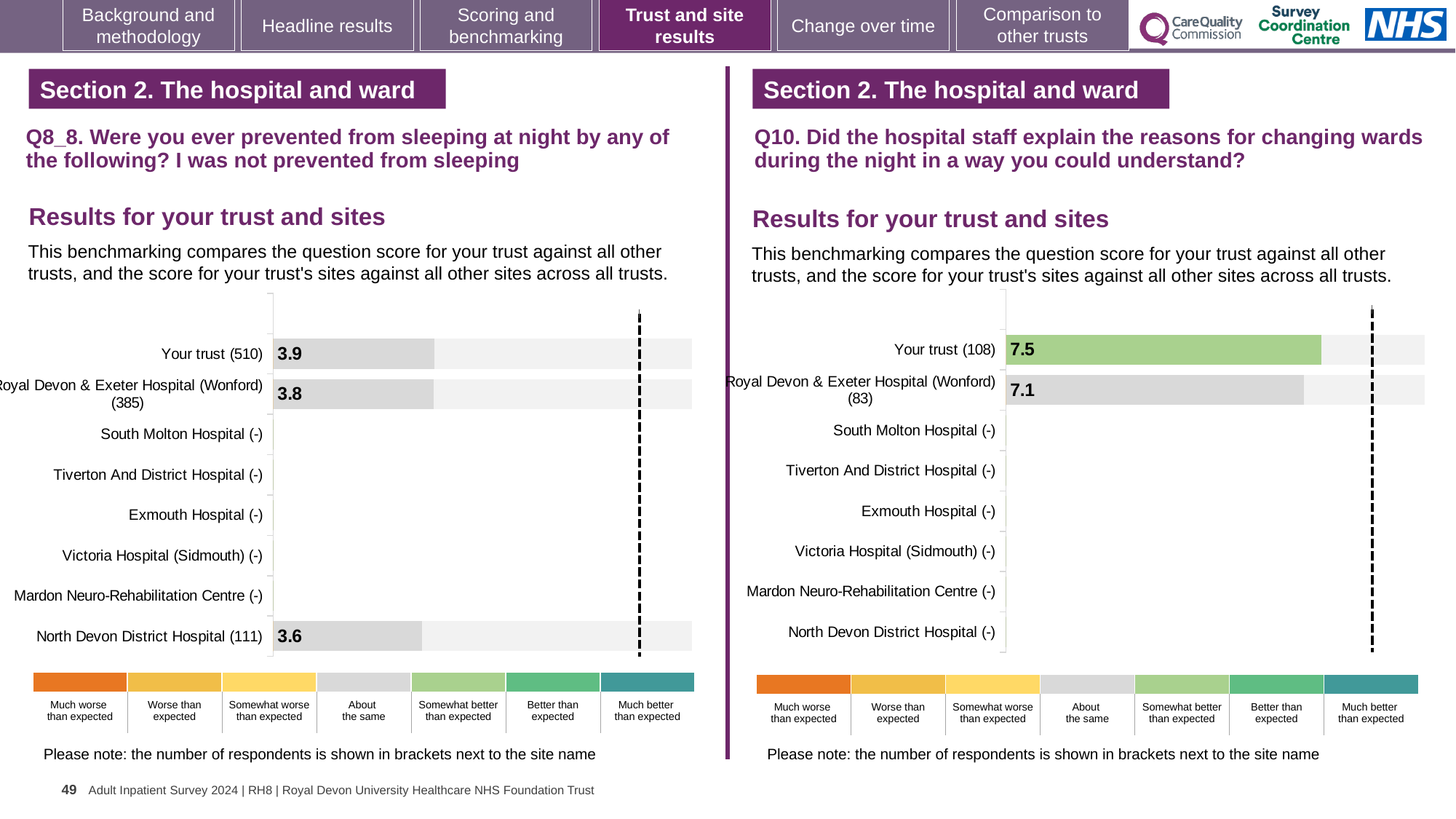
On the left chart (Q8_8), how many respondents are shown in brackets for Your trust? 510 On the right chart (Q10), which is higher: the score for Your trust or the score for Royal Devon & Exeter Hospital (Wonford)? Your trust On the left chart (Q8_8), which of the labelled bars has the lowest score? North Devon District Hospital What kind of chart is used on the left (Q8_8)? Bar chart On the right chart (Q10), which benchmark category does the colour of the Your trust bar correspond to in the legend? Somewhat better than expected On the left chart (Q8_8), what is the score for North Devon District Hospital? 3.6 On the left chart (Q8_8), what is the score for Your trust? 3.9 On the left chart (Q8_8), what is the score for Royal Devon & Exeter Hospital (Wonford)? 3.8 On the right chart (Q10), what is the score for Your trust? 7.5 On the right chart (Q10), what is the score for Royal Devon & Exeter Hospital (Wonford)? 7.1 On the right chart (Q10), what is the difference between the score for Your trust and the score for Royal Devon & Exeter Hospital (Wonford)? 0.4 On the left chart (Q8_8), what is the difference between the score for Your trust and the score for North Devon District Hospital? 0.3